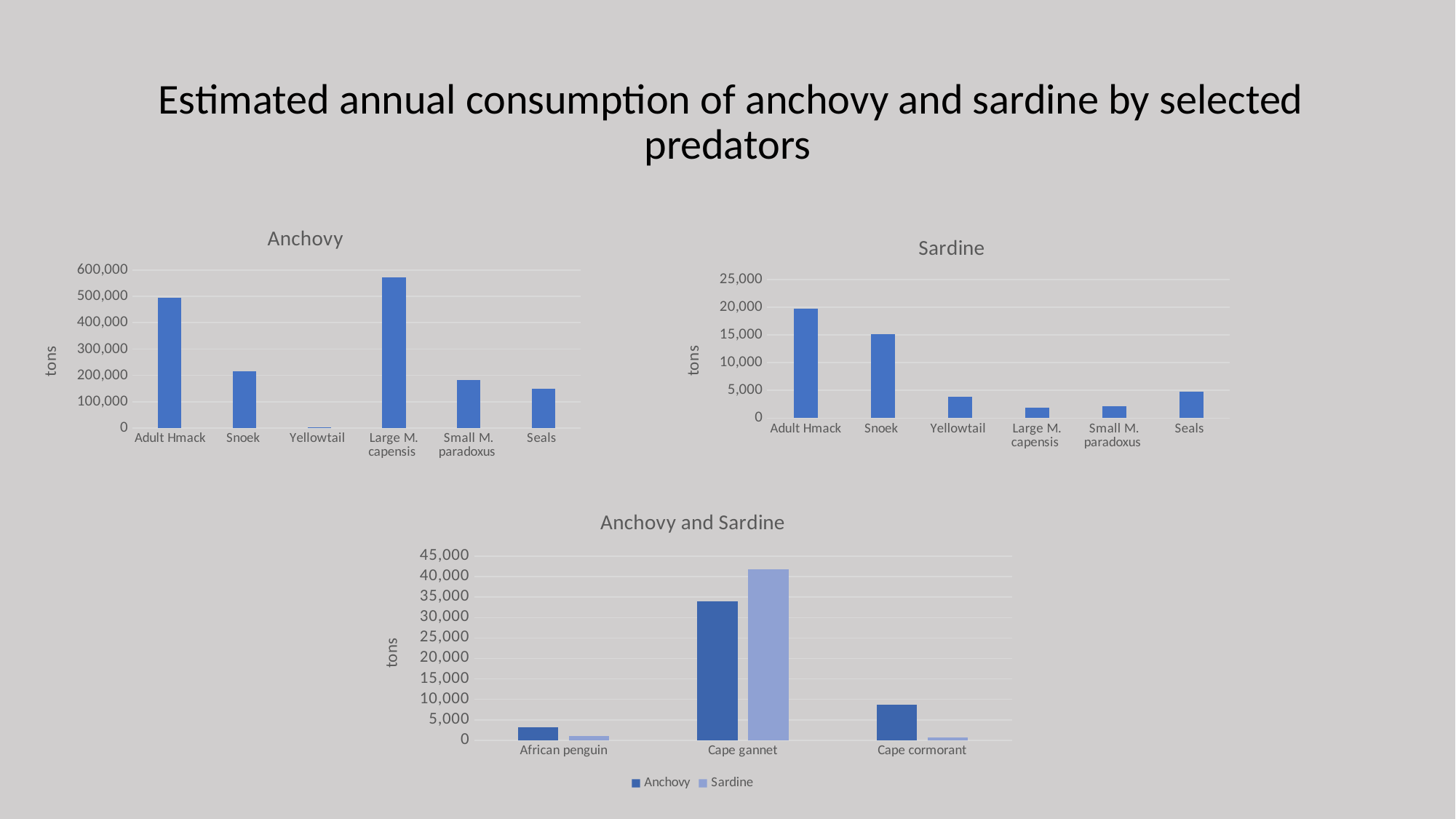
In the Anchovy chart, which is larger, the value for Small M. paradoxus or the value for Seals? Small M. paradoxus In the Anchovy chart, is the value for Adult Hmack greater or less than 400,000? greater In the Anchovy and Sardine chart, is the Sardine value for Cape gannet greater or less than 40,000? greater What kind of chart is the Anchovy and Sardine chart? Bar chart In the Sardine chart, which predator has the highest estimated annual consumption? Adult Hmack In the Anchovy chart, which predator has the lowest estimated annual consumption? Yellowtail In the Sardine chart, is the value for Snoek greater or less than 10,000? greater In the Sardine chart, which is larger, the value for Yellowtail or the value for Large M. capensis? Yellowtail In the Anchovy chart, which predator has the highest estimated annual consumption? Large M. capensis How many predator categories are shown in the Sardine chart? 6 How many series does the legend of the Anchovy and Sardine chart list? 2